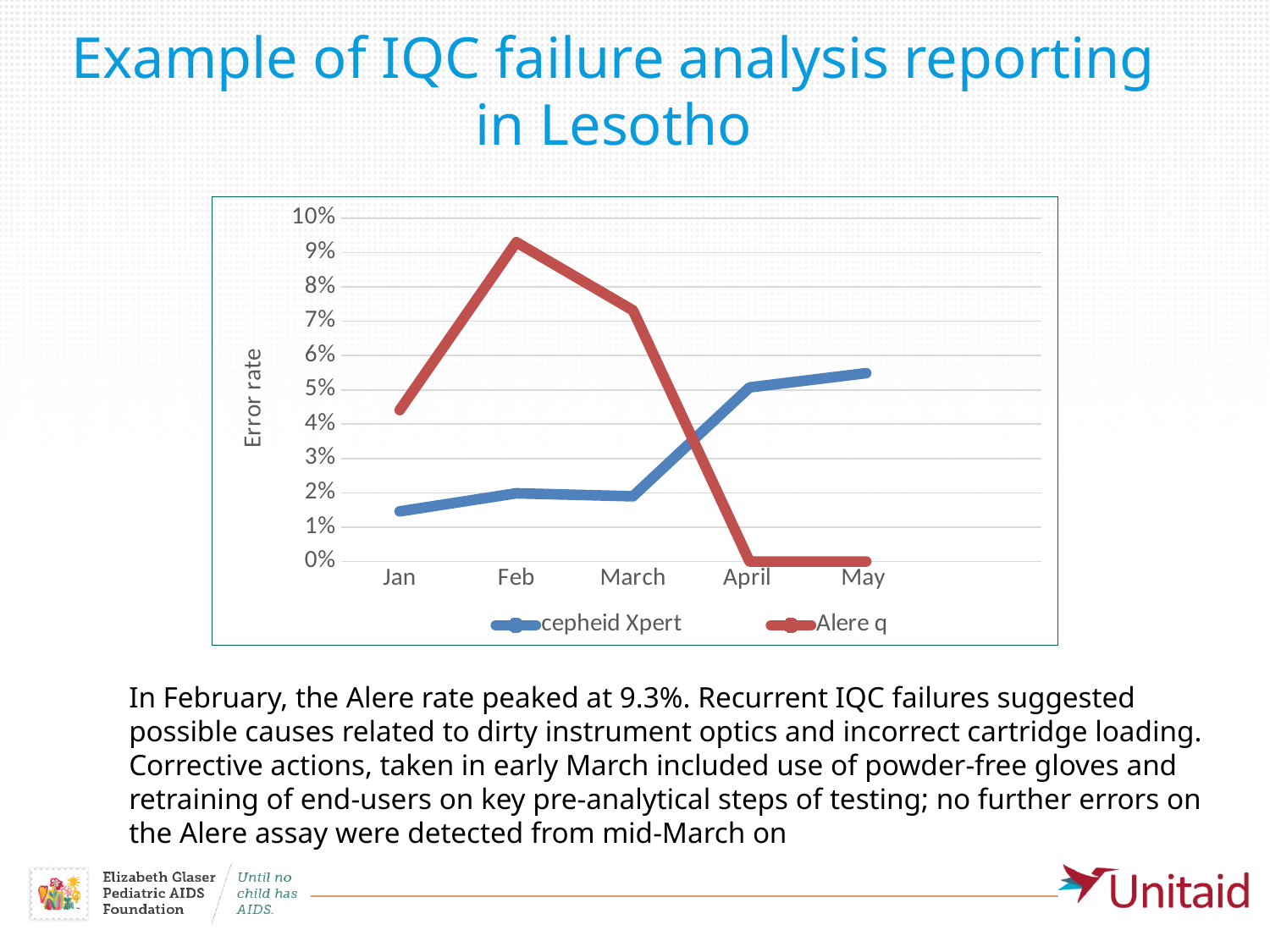
In which month is the cepheid Xpert error rate highest? May What is the label on the y axis of the chart? Error rate What kind of chart is shown on the slide? line chart In January, which series has the higher error rate, cepheid Xpert or Alere q? Alere q How many months are plotted along the x axis? 5 In which month is the Alere q error rate highest? Feb What was the Alere q error rate in February? 9.3% How many series does the legend list? 2 Does the cepheid Xpert error rate rise or fall from January to May? rise Is the cepheid Xpert error rate in May greater or less than 5%? greater What is the Alere q error rate in May? 0% Is the Alere q error rate in March greater or less than 7%? greater